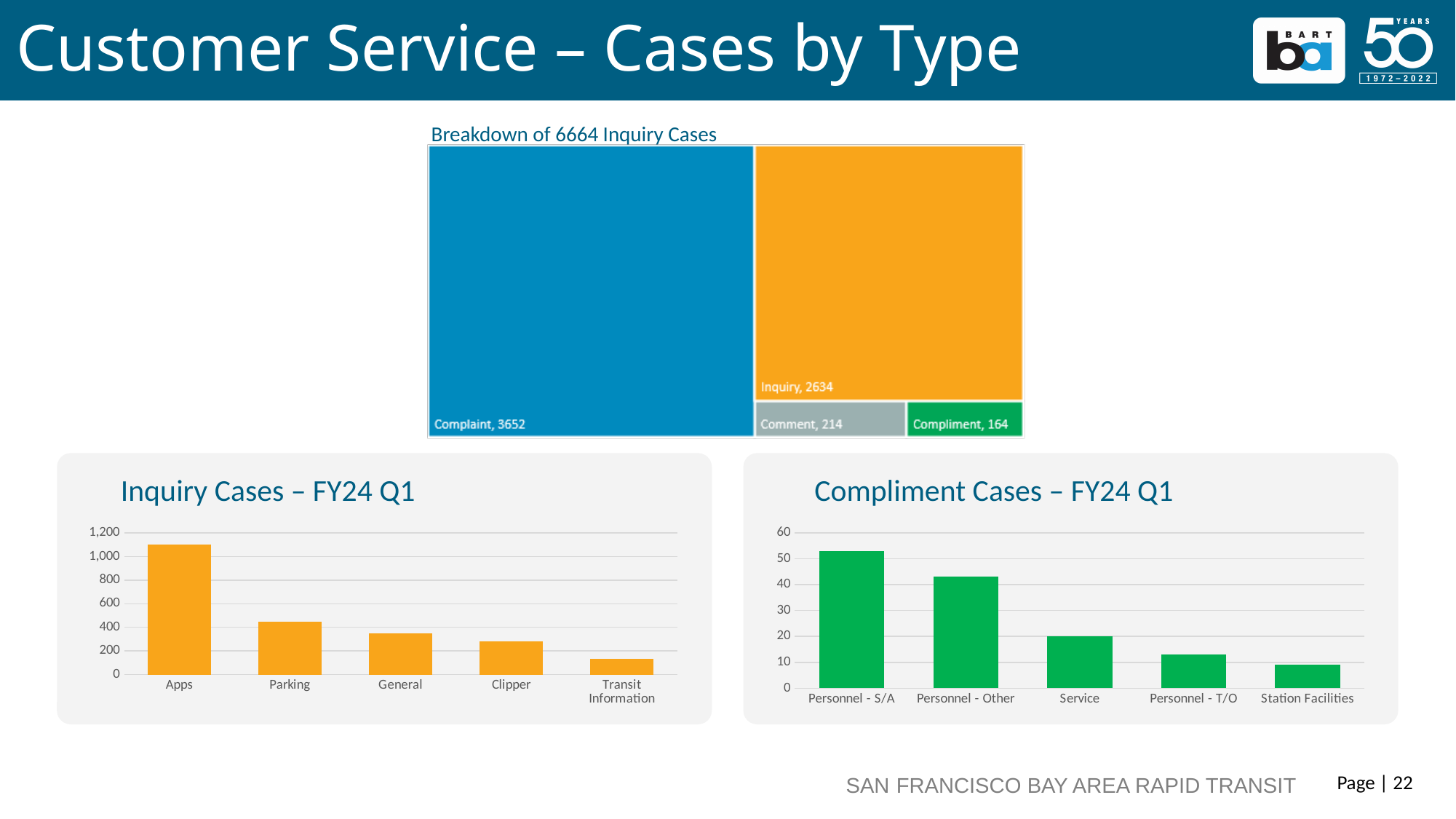
In the 'Inquiry Cases – FY24 Q1' chart, which category has the highest value? Apps In the 'Inquiry Cases – FY24 Q1' chart, is the value for Apps greater or less than 1,000? greater In the 'Compliment Cases – FY24 Q1' chart, is the value for Service greater or less than 30? less In the 'Breakdown of 6664 Inquiry Cases' treemap, which category has the largest number of cases? Complaint In the 'Inquiry Cases – FY24 Q1' chart, what kind of chart is shown? bar chart In the 'Breakdown of 6664 Inquiry Cases' treemap, what is the difference between the Inquiry and Comment case counts? 2420 In the 'Breakdown of 6664 Inquiry Cases' treemap, how many Complaint cases are shown? 3652 In the 'Compliment Cases – FY24 Q1' chart, which category has the highest value? Personnel - S/A In the 'Inquiry Cases – FY24 Q1' chart, which category has the lowest value? Transit Information In the 'Compliment Cases – FY24 Q1' chart, which is larger, Personnel - Other or Personnel - T/O? Personnel - Other In the 'Breakdown of 6664 Inquiry Cases' treemap, how many Compliment cases are shown? 164 In the 'Breakdown of 6664 Inquiry Cases' treemap, how many categories are shown? 4